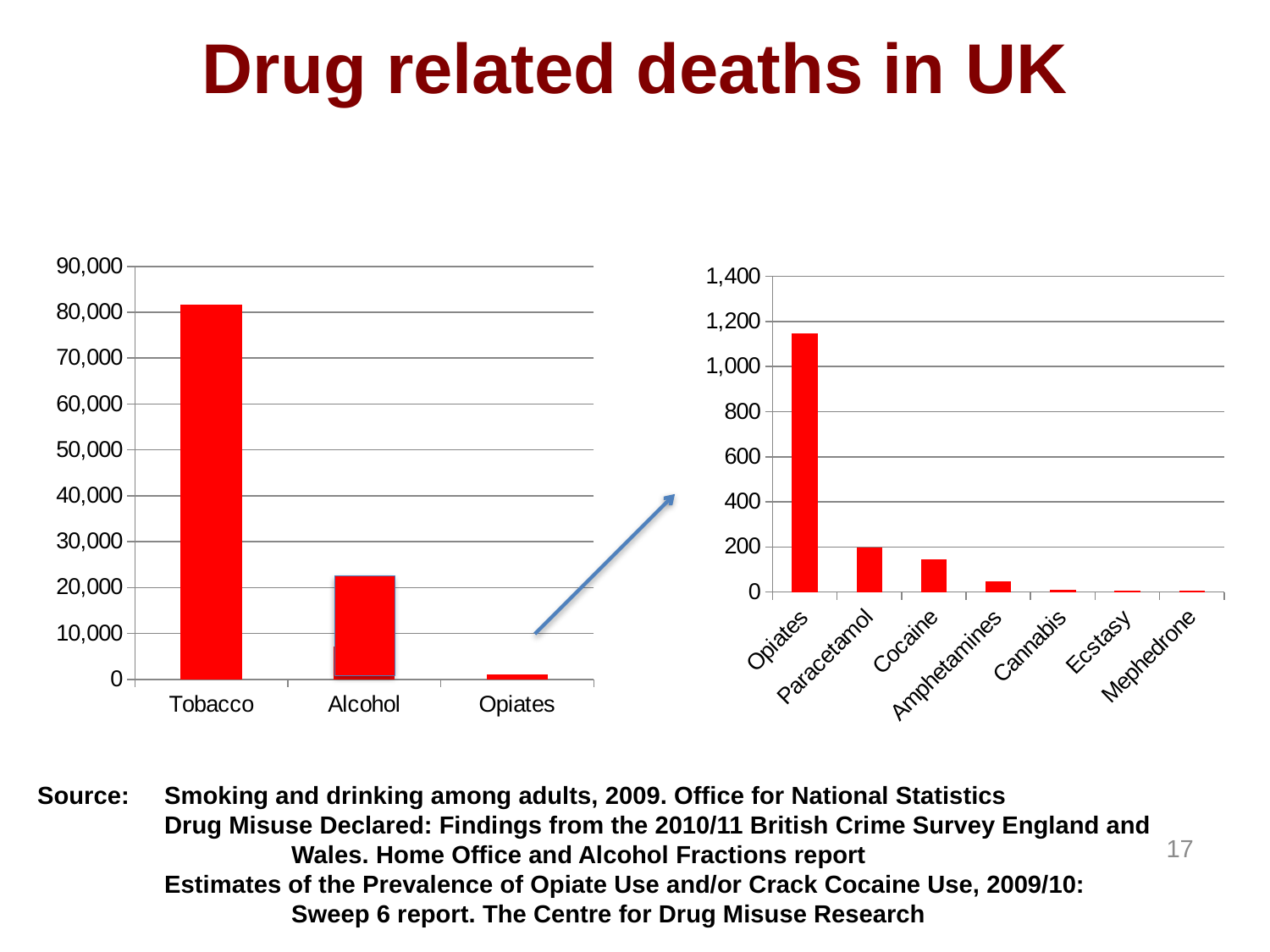
In the right chart, which is larger, the value for Paracetamol or the value for Amphetamines? Paracetamol In the left chart, how many categories are shown on the x axis? 3 In the left chart, is the value for Alcohol greater or less than 30,000? less In the left chart, which category has the lowest value? Opiates In the right chart, is the value for Opiates greater or less than 1,000? greater In the left chart, is the value for Tobacco greater or less than 70,000? greater What type of chart is the right chart? Bar chart In the right chart, how many categories are shown on the x axis? 7 In the right chart, which category has the highest value? Opiates In the left chart, which category has the highest value? Tobacco